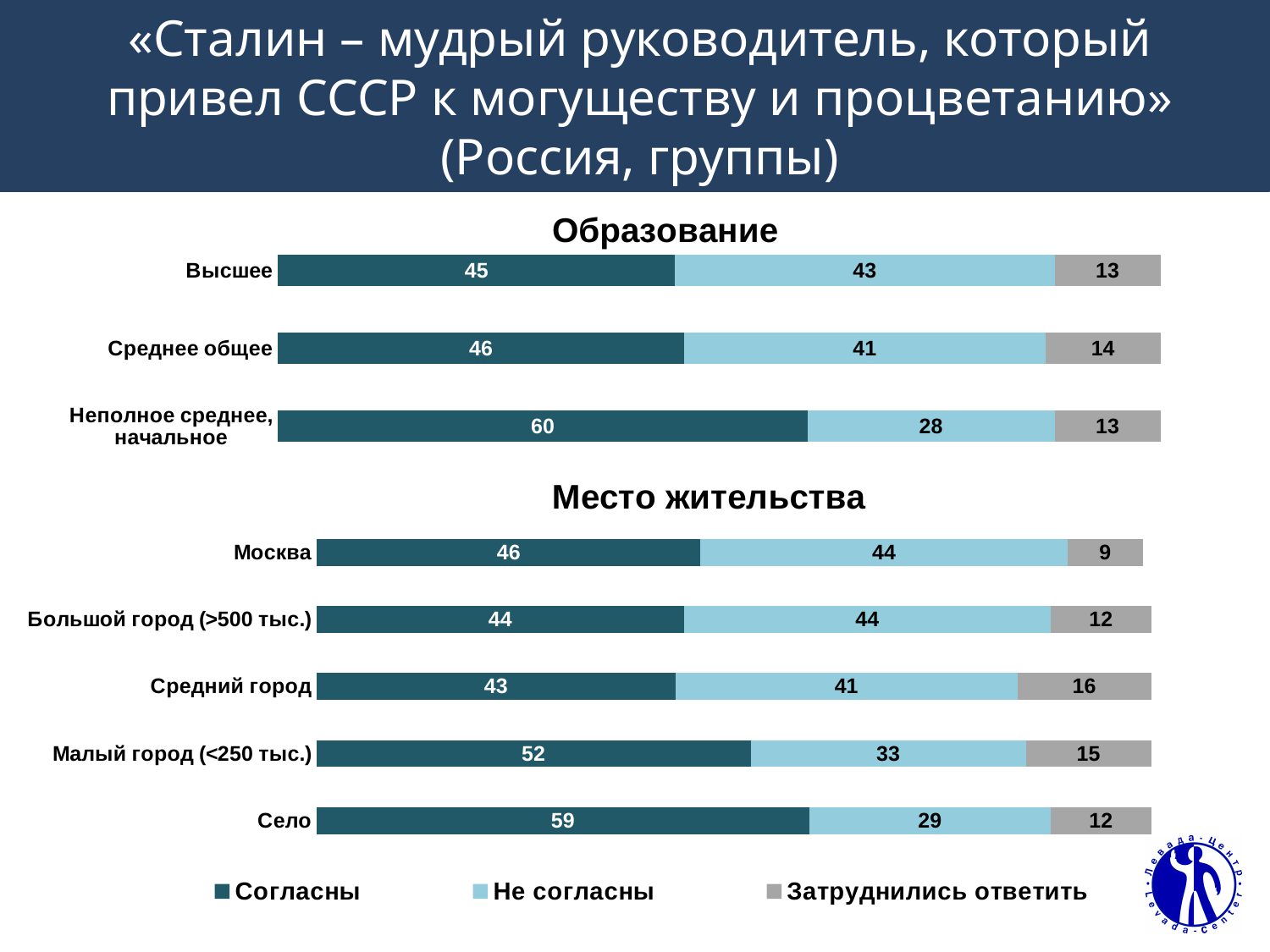
In the "Место жительства" chart, which category has the lowest value for "Не согласны"? Село In the "Образование" chart, what is the value for "Не согласны" in the "Неполное среднее, начальное" category? 28 In the "Образование" chart, what is the difference between the "Согласны" values for "Неполное среднее, начальное" and "Высшее"? 15 In the "Место жительства" chart, which is larger: the "Согласны" value for "Малый город (<250 тыс.)" or for "Средний город"? Малый город (<250 тыс.) In the "Образование" chart, what is the value for "Согласны" in the "Высшее" category? 45 In the "Образование" chart, which category has the highest value for "Согласны"? Неполное среднее, начальное What kind of chart is the "Образование" chart? Stacked bar chart In the "Место жительства" chart, which category has the highest value for "Затруднились ответить"? Средний город How many categories are shown in the "Место жительства" chart? 5 In the "Место жительства" chart, what is the value for "Затруднились ответить" in the "Москва" category? 9 How many series does the legend list? 3 In the "Образование" chart, what is the total of the stacked bar for "Среднее общее"? 101